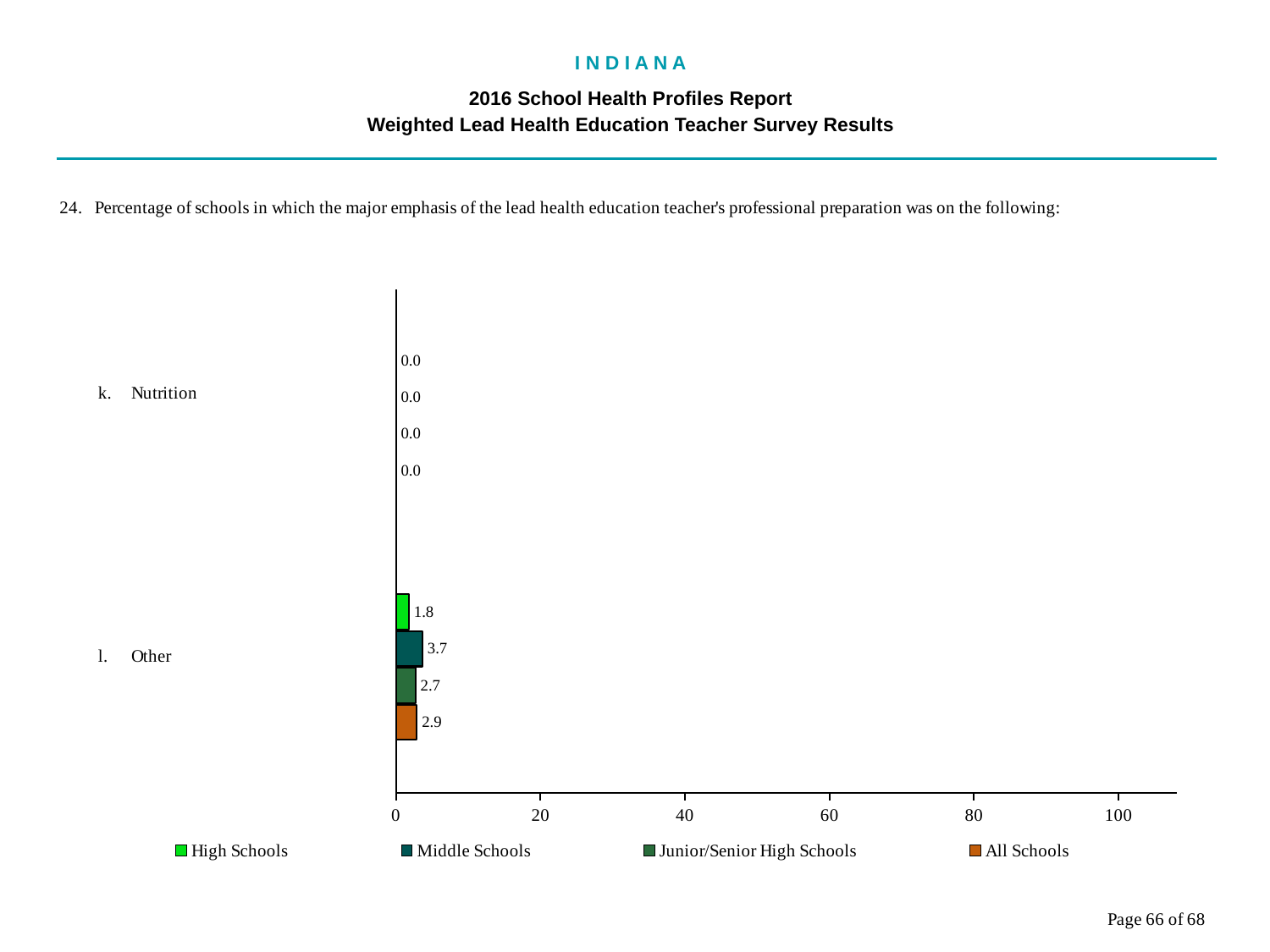
What is the value for All Schools in the Other category? 2.9 Which is larger in the Other category: All Schools or Junior/Senior High Schools? All Schools Which series has the lowest value in the Other category? High Schools What is the value for High Schools in the Other category? 1.8 Is the value for Middle Schools in the Other category greater or less than 20? less How many categories are shown on the chart? 2 Which series has the highest value in the Other category? Middle Schools What is the value for Middle Schools in the Other category? 3.7 How many series does the legend list? 4 What kind of chart is shown on the slide? bar chart What is the value for Junior/Senior High Schools in the Nutrition category? 0.0 What is the difference between the Middle Schools and High Schools values in the Other category? 1.9